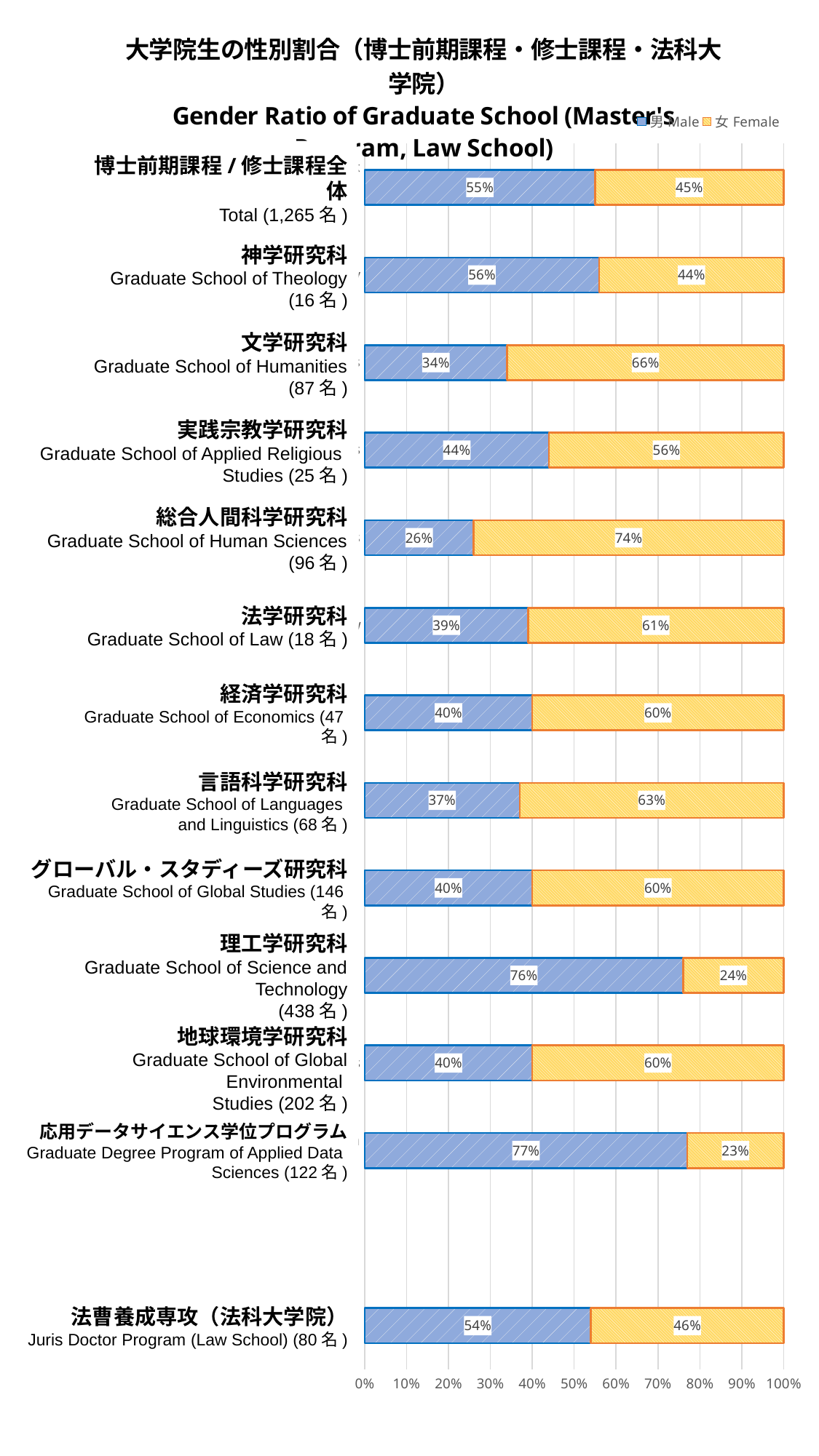
What is the difference between the Female and Male percentages for the Graduate School of Law? 22% What is the Male percentage for the Graduate School of Humanities? 34% What is the total of the Male and Female percentages for the Graduate School of Global Studies? 100% How many series does the legend list? 2 What is the Female percentage for the Graduate School of Science and Technology? 24% What is the Male percentage for the Juris Doctor Program (Law School)? 54% How many categories (rows) are plotted in the chart? 13 What kind of chart is shown on the slide? Stacked bar chart Which has a larger Male percentage: the Graduate School of Theology or the Graduate School of Economics? Graduate School of Theology Which category has the highest Male percentage? Graduate Degree Program of Applied Data Sciences Which graduate school has the highest Female percentage? Graduate School of Human Sciences Which graduate school has the lowest Male percentage? Graduate School of Human Sciences